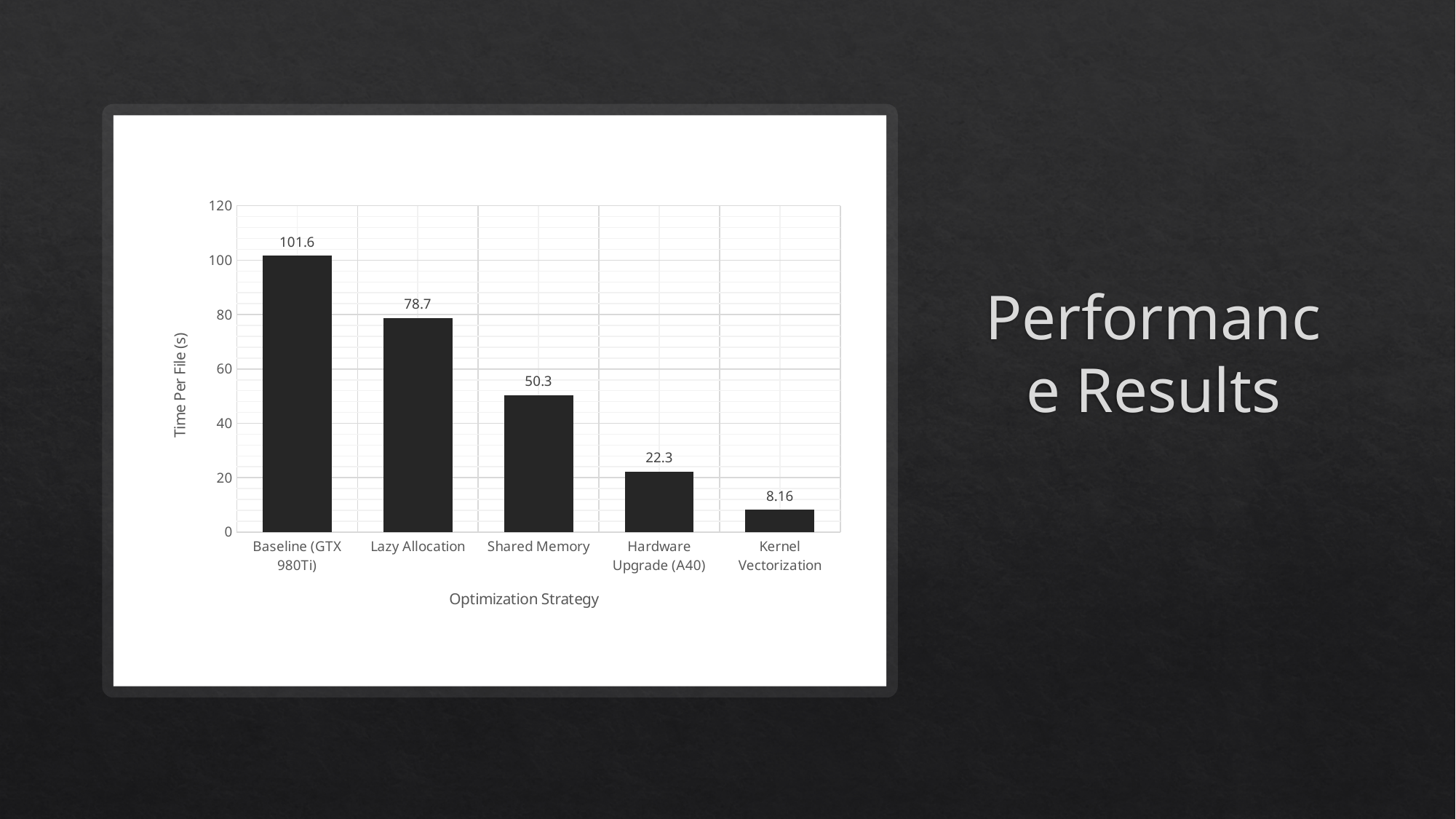
What is the time per file for Baseline (GTX 980Ti)? 101.6 Which has a larger time per file, Shared Memory or Hardware Upgrade (A40)? Shared Memory What is the time per file for Kernel Vectorization? 8.16 How many optimization strategies are shown on the chart? 5 Do the values rise or fall from left to right along the x axis? fall Which optimization strategy has the lowest time per file? Kernel Vectorization Is the value for Hardware Upgrade (A40) greater or less than 40? less What is the difference in time per file between Shared Memory and Hardware Upgrade (A40)? 28 What is the difference in time per file between Baseline (GTX 980Ti) and Lazy Allocation? 22.9 Which optimization strategy has the highest time per file? Baseline (GTX 980Ti) What is the time per file for Lazy Allocation? 78.7 What kind of chart is shown on the slide? bar chart